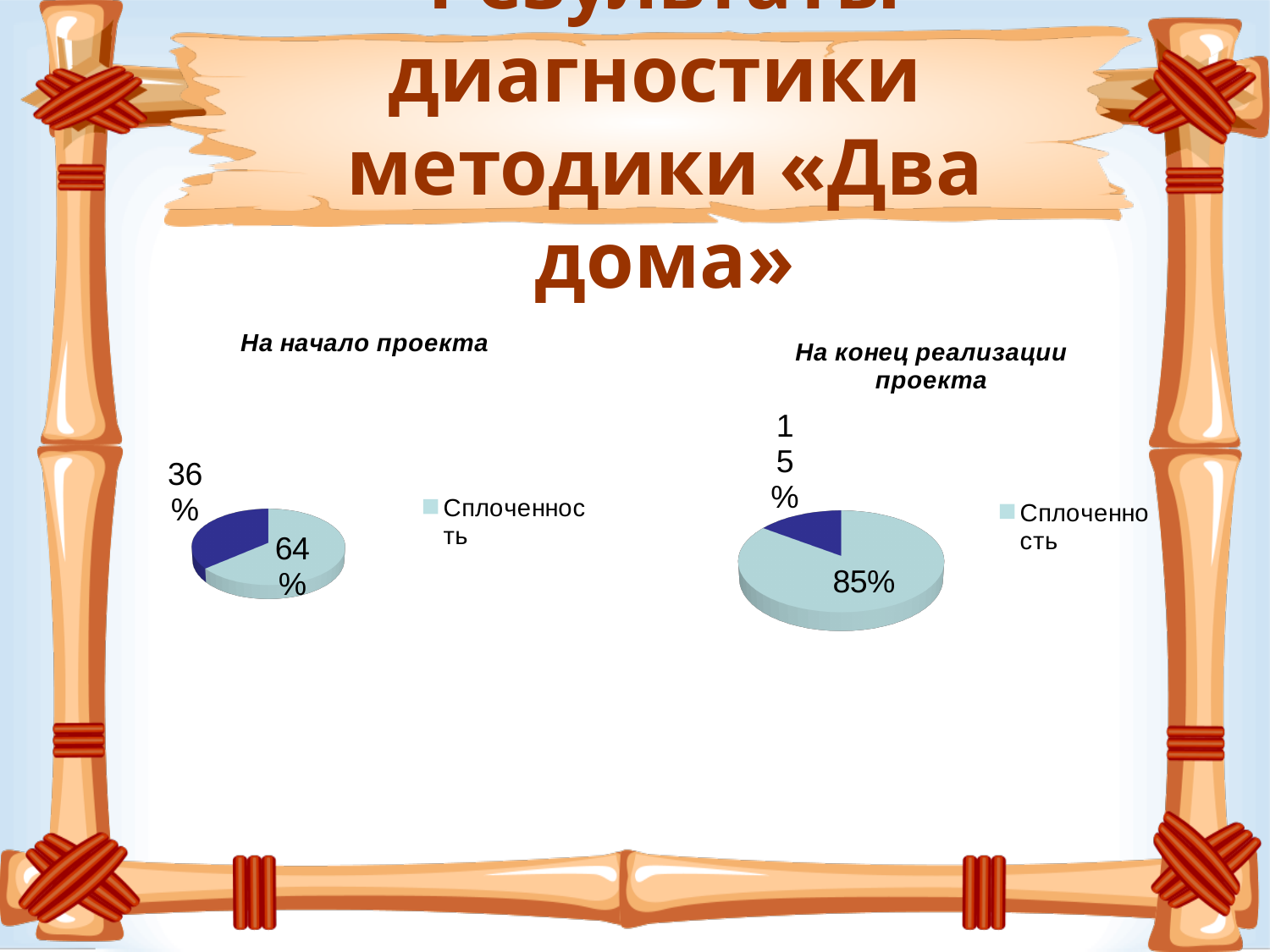
In the chart titled "На конец реализации проекта", what share does the "Сплоченность" slice have? 85% In the chart titled "На конец реализации проекта", what share does the dark blue slice have? 15% How many entries does the legend of the chart titled "На начало проекта" list? 1 What kind of chart is the chart titled "На начало проекта"? pie chart What is the legend entry shown next to the chart titled "На конец реализации проекта"? Сплоченность How many slices does the chart titled "На конец реализации проекта" have? 2 In the chart titled "На начало проекта", what share does the dark blue slice have? 36% In the chart titled "На конец реализации проекта", what is the difference between the two slices' shares? 70% In the chart titled "На конец реализации проекта", which slice is the smallest? the dark blue slice (15%) In the chart titled "На начало проекта", what is the difference between the two slices' shares? 28% In the chart titled "На начало проекта", which slice is larger: the light blue "Сплоченность" slice or the dark blue slice? the light blue "Сплоченность" slice